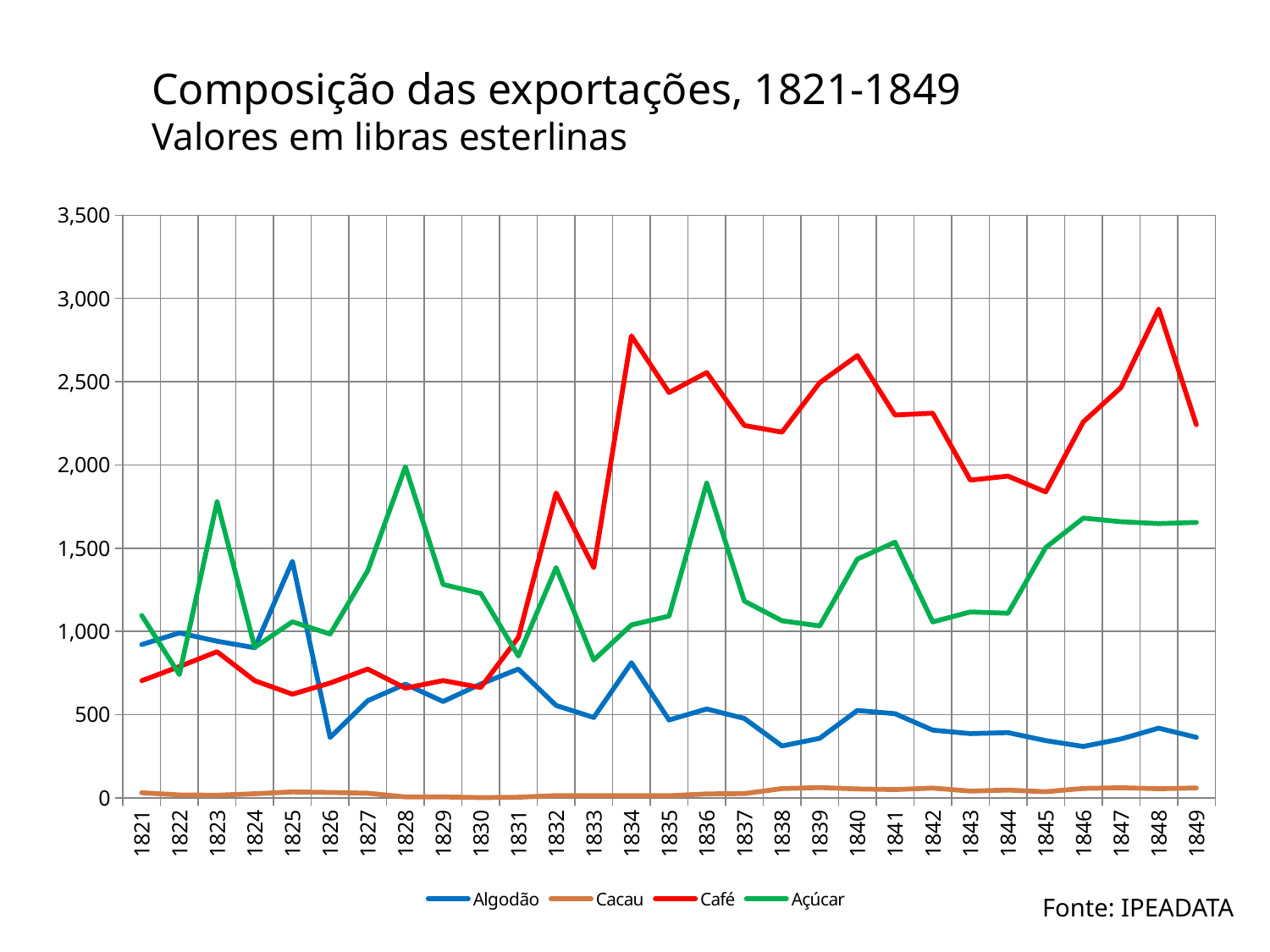
Which series has the highest value in 1848? Café How many years are plotted along the x axis? 29 Is the value for Algodão in 1826 greater or less than 500? less Which series has the lowest value in 1840? Cacau In 1825, which is larger: Algodão or Café? Algodão In 1849, which is larger: Café or Açúcar? Café Is the value for Café in 1848 greater or less than 2,500? greater In which year does Café reach its highest value? 1848 What kind of chart is shown on the slide? line chart How many series does the legend list? 4 Is the value for Açúcar in 1828 greater or less than 1,500? greater What is the source cited for the chart? IPEADATA